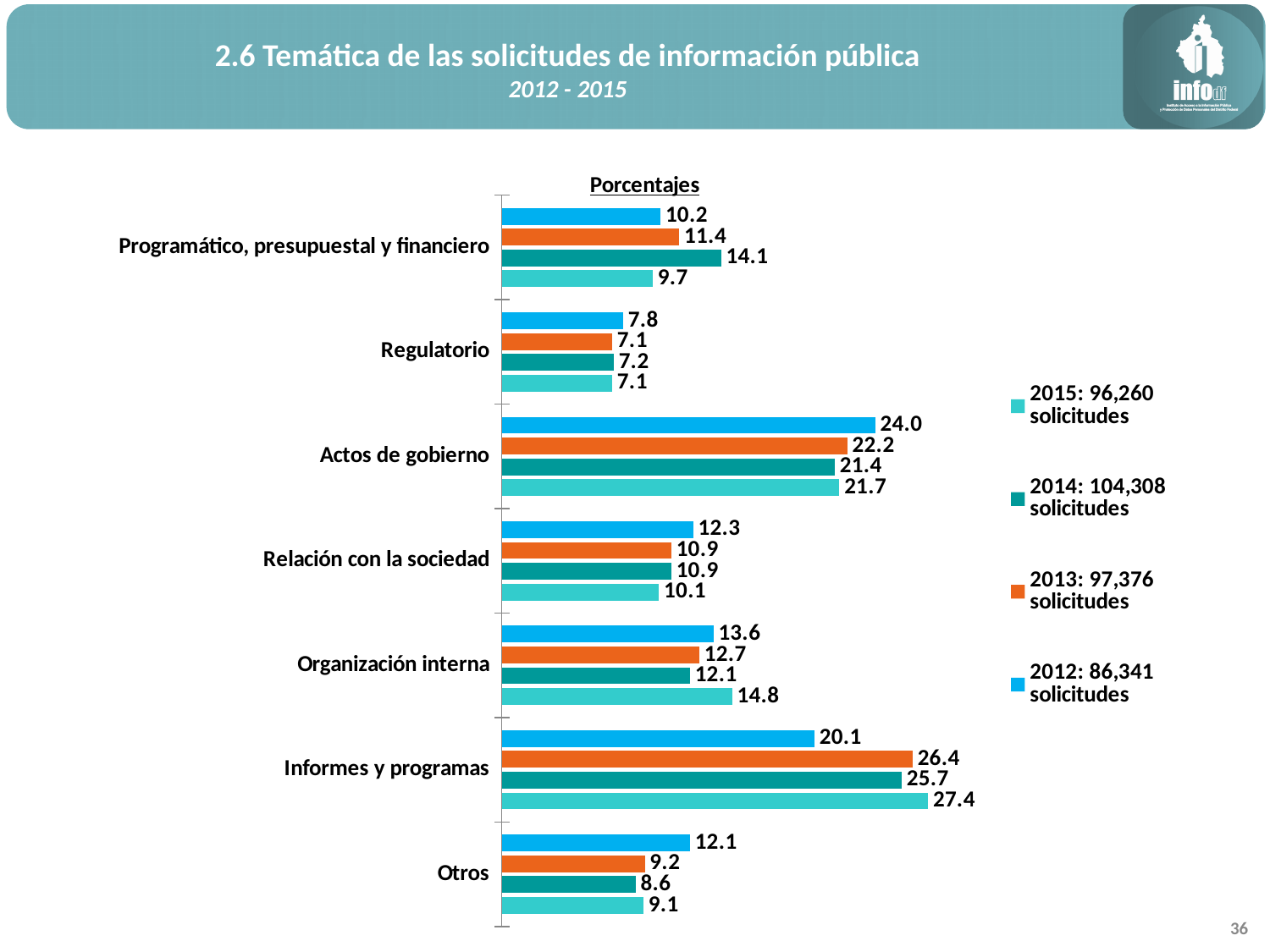
What is the 2015 value for Informes y programas? 27.4 What is the 2012 value for Actos de gobierno? 24.0 How many series does the legend list? 4 For Organización interna, which is larger: the 2015 value or the 2014 value? 2015 Which category has the lowest 2012 value? Regulatorio According to the legend, how many solicitudes were there in 2014? 104,308 What is the 2014 value for Programático, presupuestal y financiero? 14.1 What is the 2013 value for Otros? 9.2 Which category has the highest 2015 value? Informes y programas What is the difference between the 2013 and 2012 values for Informes y programas? 6.3 What type of chart is shown on the slide? bar chart How many categories (temáticas) are shown on the chart? 7